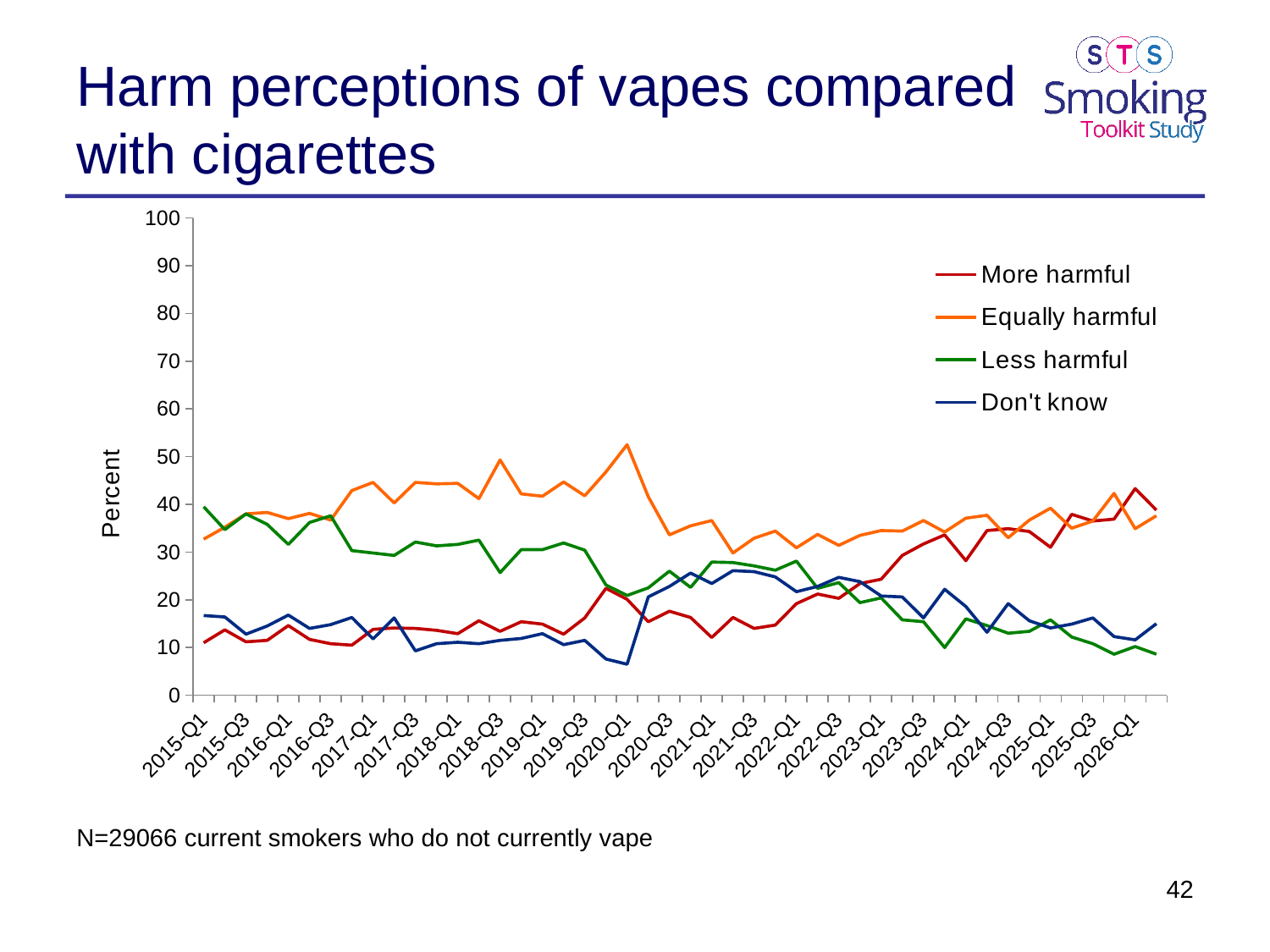
Which series is shown in orange in the legend? Equally harmful Is the value for Less harmful at 2015-Q1 greater or less than 30? greater Which series has the lowest value at 2026-Q1? Less harmful What kind of chart is shown on the slide? line chart What is the label on the vertical axis? Percent Is the value for More harmful at 2015-Q1 greater or less than 20? less Which series has the highest value at 2015-Q1? Less harmful Does the Less harmful series generally rise or fall from 2015-Q1 to 2026-Q1? fall At 2020-Q1, which is larger: Equally harmful or Less harmful? Equally harmful Is the value for Equally harmful at 2020-Q1 greater or less than 50? greater How many series does the legend list? 4